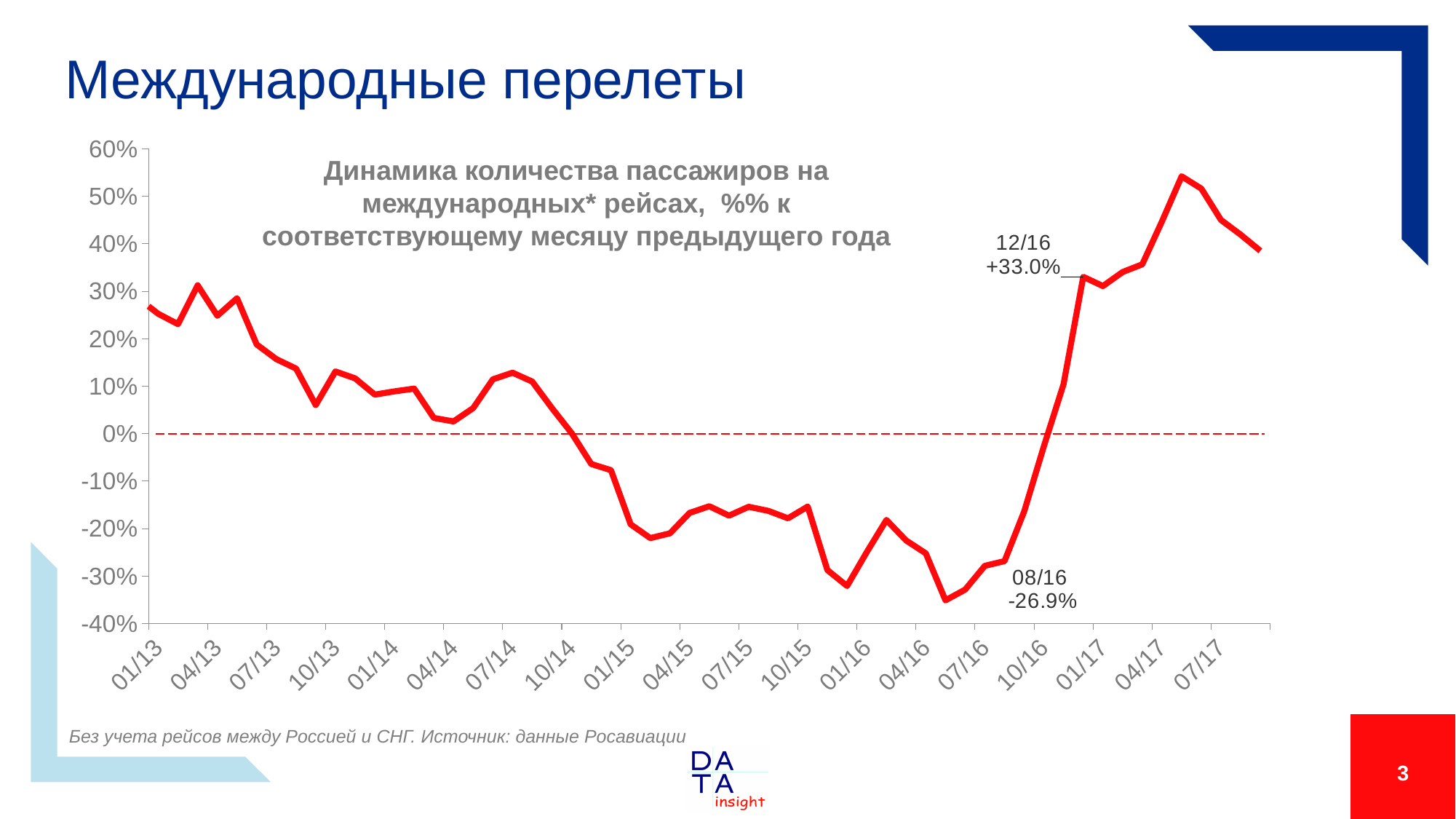
What value is labelled for 12/16? +33.0% Is the value for 07/17 greater or less than 40%? greater What kind of chart is shown on the slide? line chart What level does the dashed horizontal line on the chart mark? 0% Is the value for 04/15 greater or less than -10%? less Is the highest point of the line greater or less than 50%? greater What value is labelled for 08/16? -26.9% Which of the two labelled points is higher, 12/16 or 08/16? 12/16 Does the line rise or fall overall between 01/13 and 07/13? fall What is the difference between the labelled values for 12/16 and 08/16? 59.9 percentage points Does the line rise or fall between 07/16 and 01/17? rise